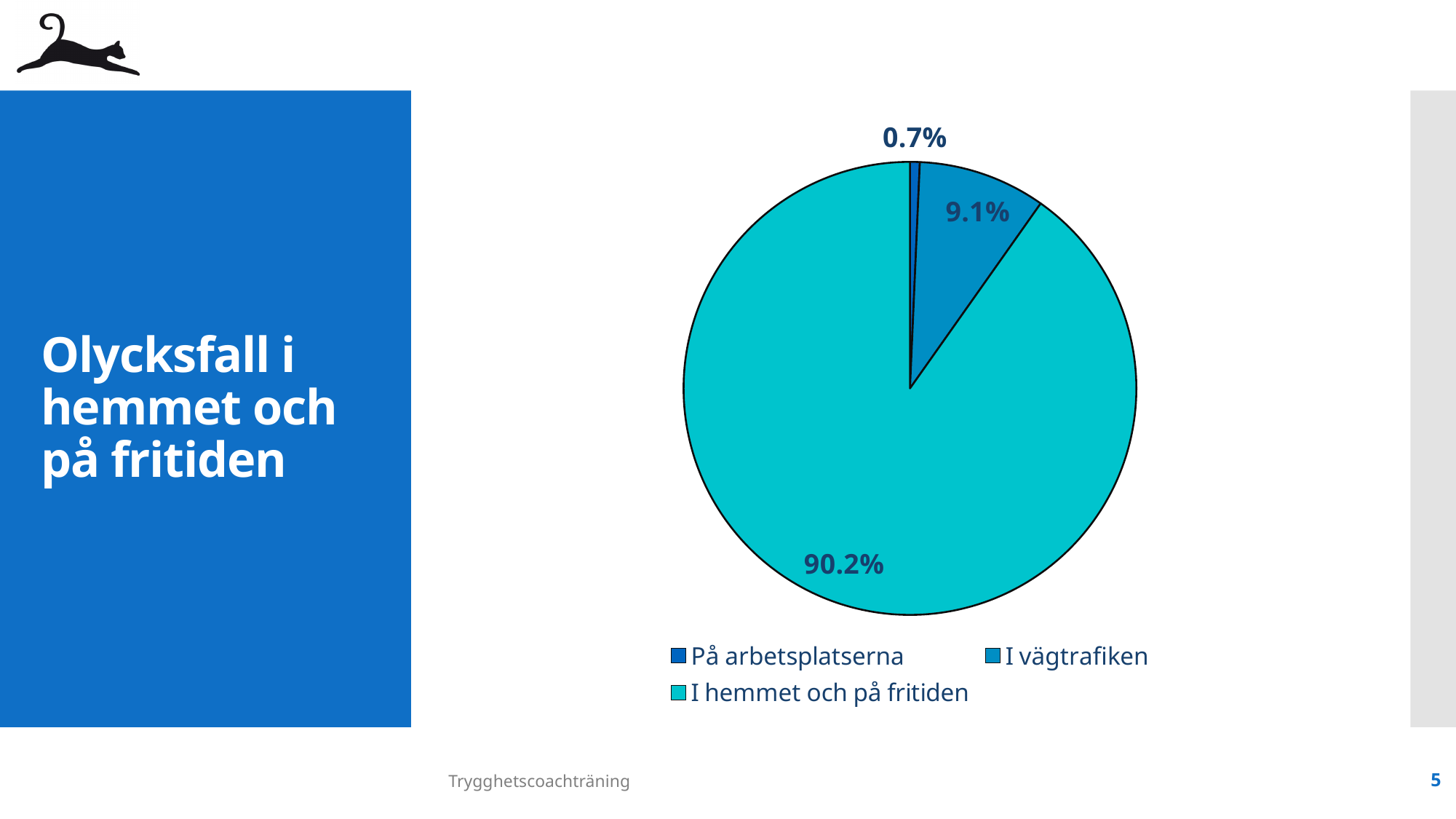
What share of the pie does "På arbetsplatserna" have? 0.7% Which category has the smallest slice of the pie? På arbetsplatserna What is the difference in percentage points between "I hemmet och på fritiden" and "I vägtrafiken"? 81.1 What share of the pie does "I vägtrafiken" have? 9.1% Which category has the largest slice of the pie? I hemmet och på fritiden Which legend entry is shown in the lightest (turquoise) colour? I hemmet och på fritiden Which is larger, the slice for "I vägtrafiken" or the slice for "På arbetsplatserna"? I vägtrafiken What is the difference in percentage points between "I vägtrafiken" and "På arbetsplatserna"? 8.4 How many entries does the legend list? 3 How many slices does the pie chart have? 3 What kind of chart is shown on the slide? pie chart What share of the pie does "I hemmet och på fritiden" have? 90.2%